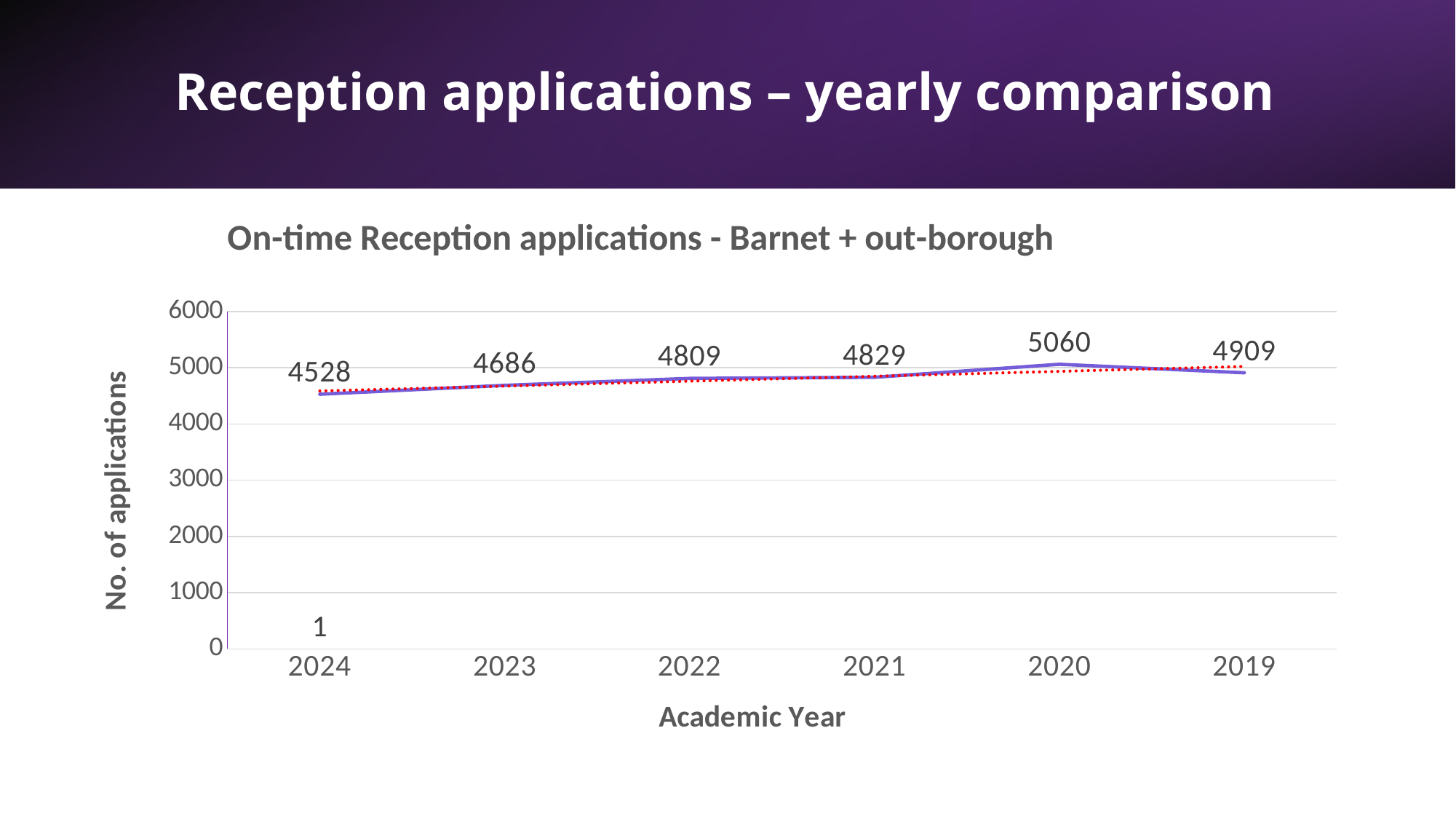
What is the difference between the values for 2020 and 2024? 532 What is the value for 2024 in the On-time Reception applications chart? 4528 Which is larger, the value for 2021 or the value for 2022? 2021 What is the difference between the values for 2023 and 2024? 158 Which academic year has the lowest number of on-time Reception applications? 2024 What is the value for 2022 in the On-time Reception applications chart? 4809 What kind of chart is shown on the slide? Line chart What is the value for 2019 in the On-time Reception applications chart? 4909 What is the title of the chart on the slide? On-time Reception applications - Barnet + out-borough What is the value for 2020 in the On-time Reception applications chart? 5060 How many academic years are plotted on the x axis of the chart? 6 Which academic year has the highest number of on-time Reception applications? 2020